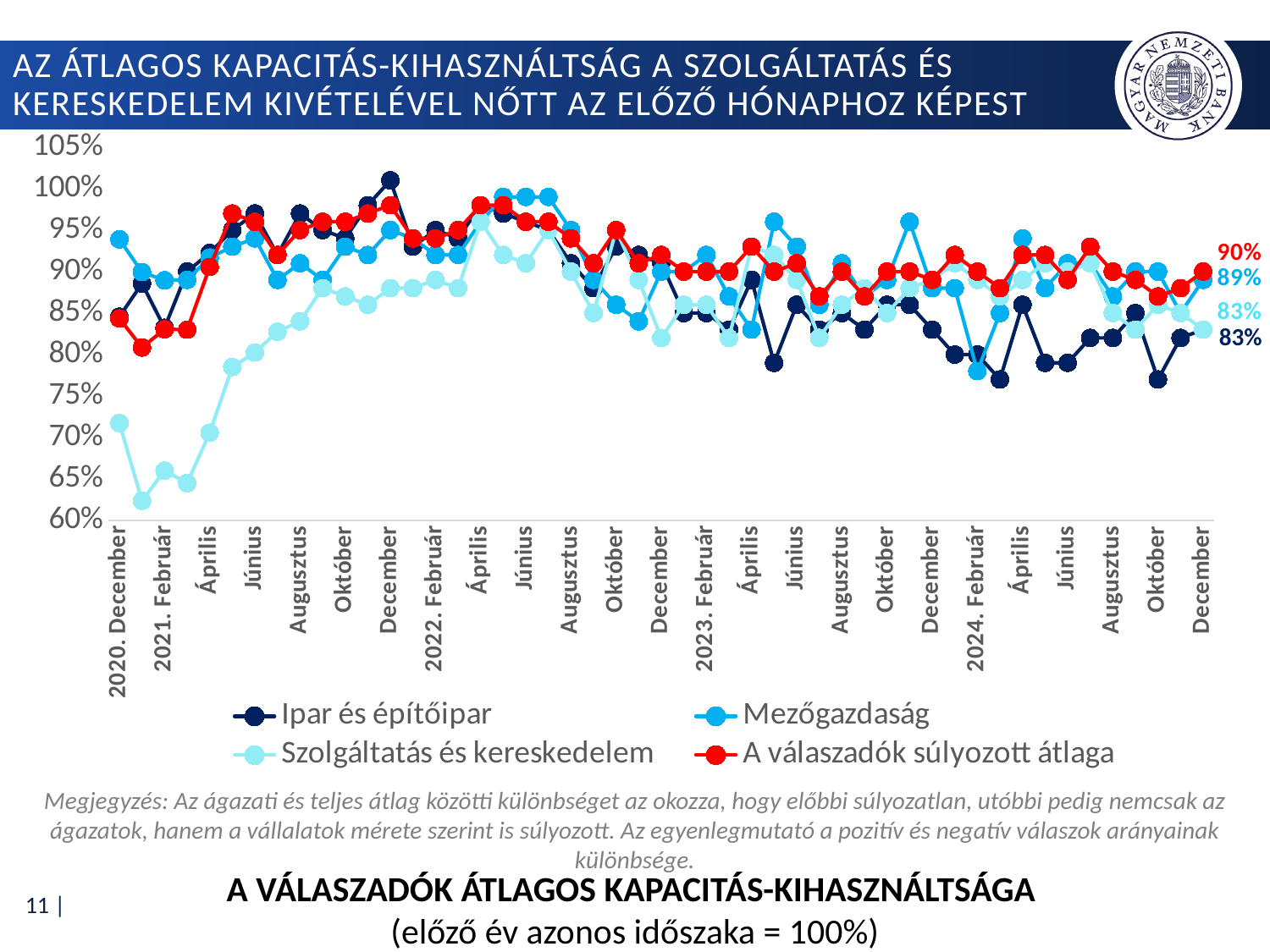
Which series has the highest value at the last point (2024 December)? A válaszadók súlyozott átlaga What is the value of 'Ipar és építőipar' at the last point (2024 December)? 83% What kind of chart is shown on the slide? line chart What is the value of 'A válaszadók súlyozott átlaga' at the last point (2024 December)? 90% At the last point (2024 December), which is larger: 'Mezőgazdaság' or 'Szolgáltatás és kereskedelem'? Mezőgazdaság Is the value for 'Szolgáltatás és kereskedelem' in 2020 December greater or less than 75%? less Which series is drawn in red? A válaszadók súlyozott átlaga Does the 'Szolgáltatás és kereskedelem' series rise or fall between 2020 December and 2022 April? rise How many series does the legend list? 4 What is the value of 'Szolgáltatás és kereskedelem' at the last point (2024 December)? 83% What is the value of 'Mezőgazdaság' at the last point (2024 December)? 89% What is the difference between 'A válaszadók súlyozott átlaga' and 'Ipar és építőipar' at the last point (2024 December)? 7 percentage points